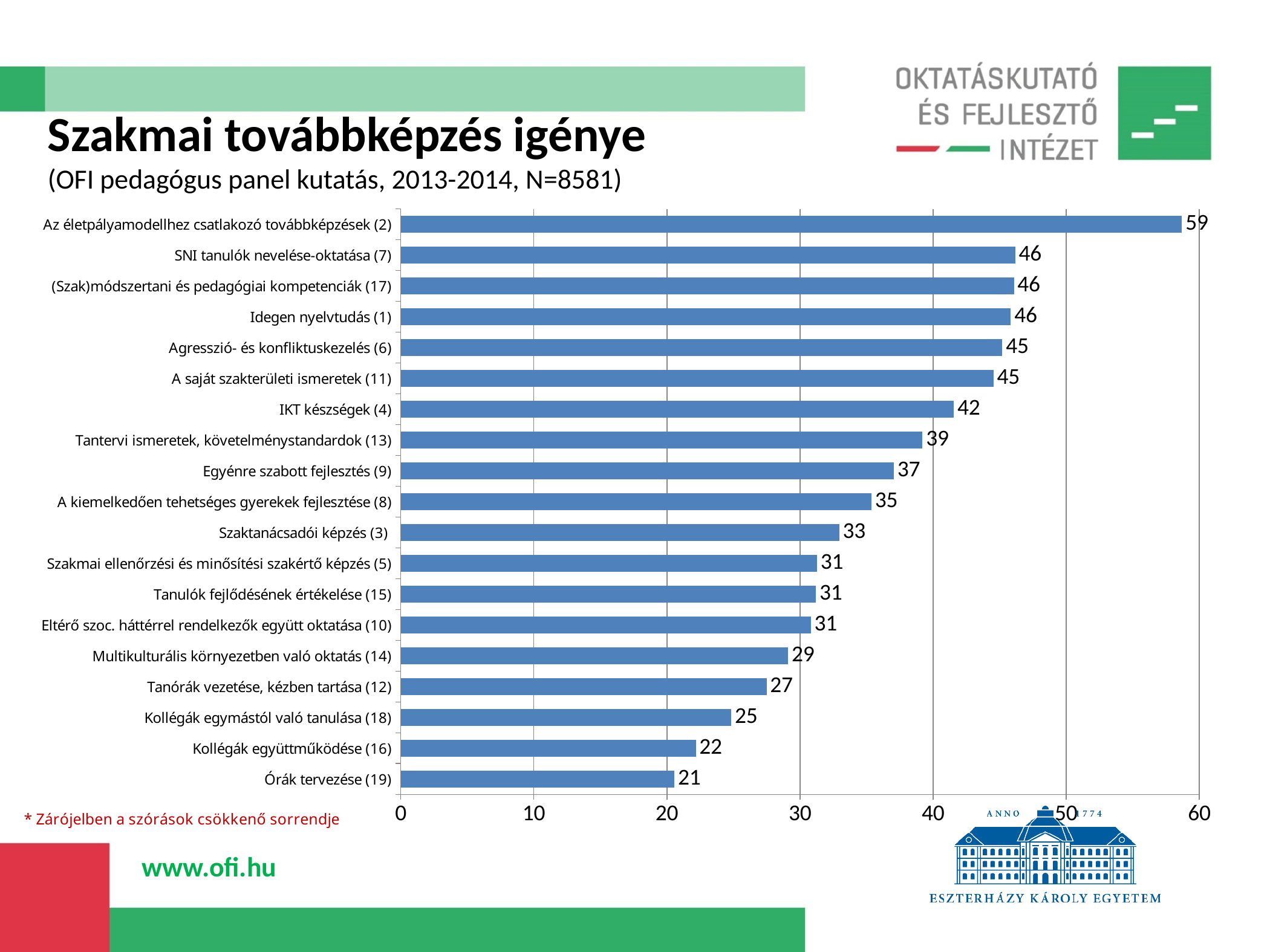
What is the value for "Órák tervezése (19)"? 21 What is the value for "Az életpályamodellhez csatlakozó továbbképzések (2)"? 59 Which category has the lowest value? Órák tervezése (19) Which is larger: the value for "Tanórák vezetése, kézben tartása (12)" or "Kollégák együttműködése (16)"? Tanórák vezetése, kézben tartása (12) Which category has the highest value? Az életpályamodellhez csatlakozó továbbképzések (2) How many categories are shown in the chart? 19 What is the difference between the values for "Az életpályamodellhez csatlakozó továbbképzések (2)" and "Órák tervezése (19)"? 38 What is the title of the slide? Szakmai továbbképzés igénye What is the value for "Szaktanácsadói képzés (3)"? 33 What is the value for "IKT készségek (4)"? 42 What is the difference between the values for "IKT készségek (4)" and "Egyénre szabott fejlesztés (9)"? 5 What kind of chart is shown on the slide? Bar chart